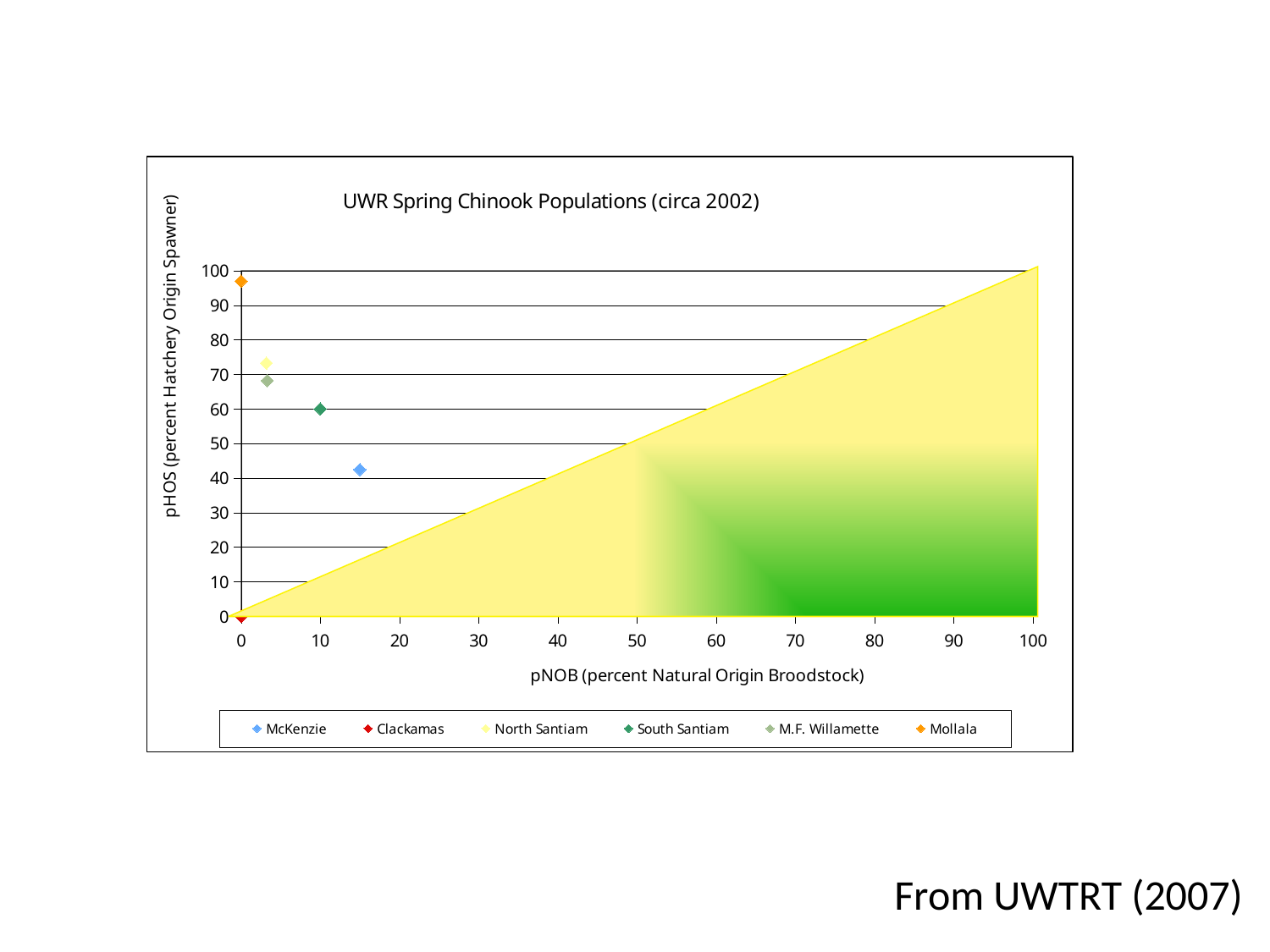
Is the pHOS value for Mollala greater or less than 90? greater Is the pHOS value for McKenzie greater or less than 50? less Which population has the lowest pHOS value? Clackamas Which population has the highest pHOS value? Mollala What kind of chart is shown on the slide? scatter chart Which has a higher pHOS value, North Santiam or South Santiam? North Santiam What is the title of the chart? UWR Spring Chinook Populations (circa 2002) What is the pNOB value for South Santiam? 10 Which has a higher pNOB value, McKenzie or South Santiam? McKenzie What is the label of the x axis? pNOB (percent Natural Origin Broodstock) How many series does the legend list? 6 What is the pHOS value for Clackamas? 0